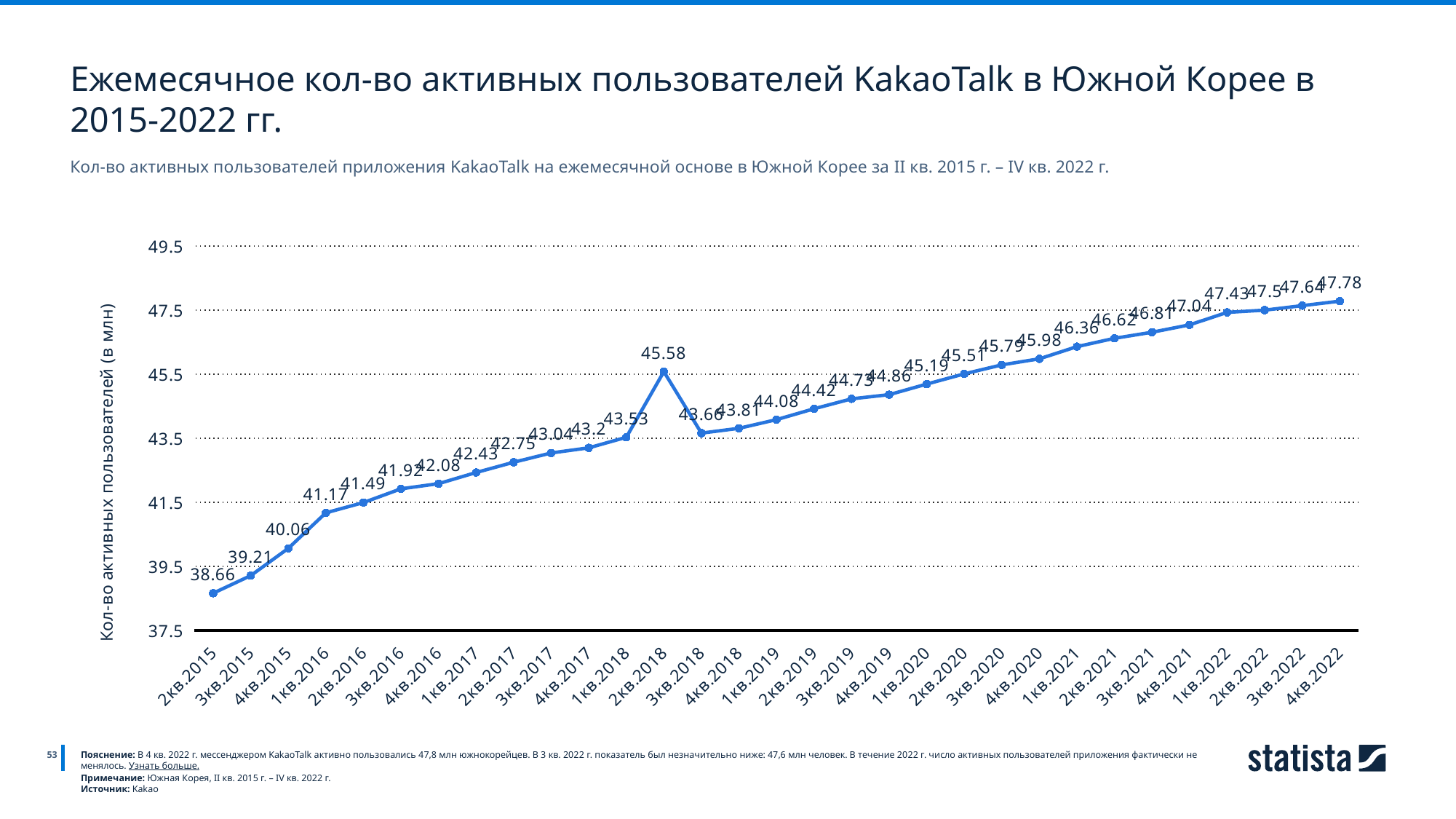
What is the value for 2кв.2018? 45.58 What is the difference between the values for 2кв.2018 and 1кв.2018? 2.05 How many data points are plotted on the chart? 31 Which quarter has the lowest value? 2кв.2015 Which is larger, the value for 2кв.2018 or the value for 3кв.2018? 2кв.2018 What type of chart is shown on the slide? Line chart What is the value for 2кв.2015? 38.66 Do the values generally rise or fall from 2кв.2015 to 4кв.2022? Rise What is the value for 4кв.2022? 47.78 What is the label of the vertical axis? Кол-во активных пользователей (в млн) Which quarter has the highest value? 4кв.2022 What is the value for 1кв.2020? 45.19